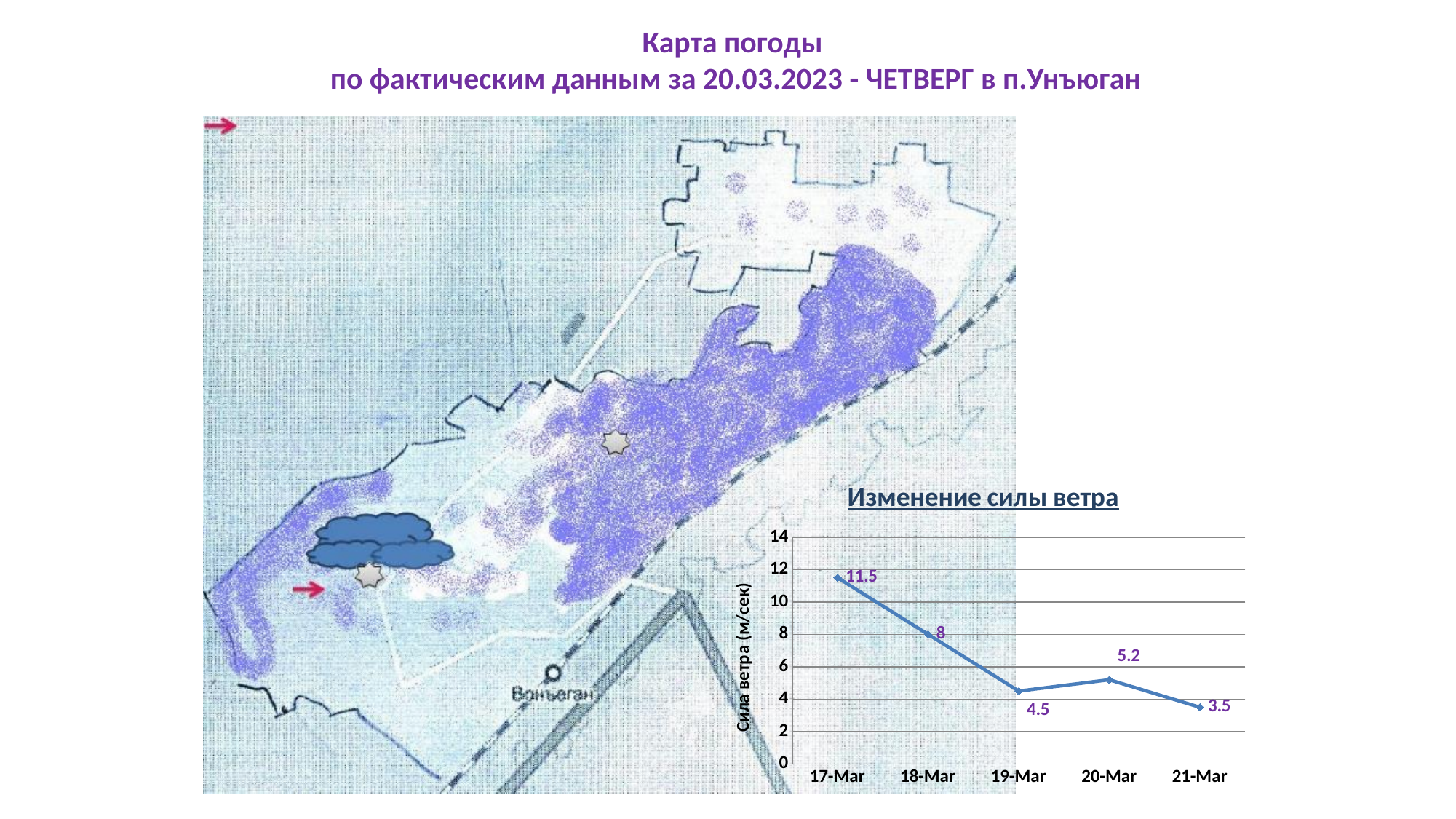
What is the wind speed value for 21-Mar in the 'Изменение силы ветра' chart? 3.5 What is the wind speed value for 18-Mar in the 'Изменение силы ветра' chart? 8 How many dates are plotted on the x axis of the 'Изменение силы ветра' chart? 5 What is the wind speed value for 17-Mar in the 'Изменение силы ветра' chart? 11.5 Which date has the lowest wind speed in the 'Изменение силы ветра' chart? 21-Mar What is the y-axis label of the 'Изменение силы ветра' chart? Сила ветра (м/сек) What is the wind speed value for 20-Mar in the 'Изменение силы ветра' chart? 5.2 What is the difference between the wind speed on 17-Mar and on 18-Mar in the 'Изменение силы ветра' chart? 3.5 What kind of chart is 'Изменение силы ветра'? line chart What is the wind speed value for 19-Mar in the 'Изменение силы ветра' chart? 4.5 In the 'Изменение силы ветра' chart, which date has a higher wind speed, 19-Mar or 20-Mar? 20-Mar Which date has the highest wind speed in the 'Изменение силы ветра' chart? 17-Mar